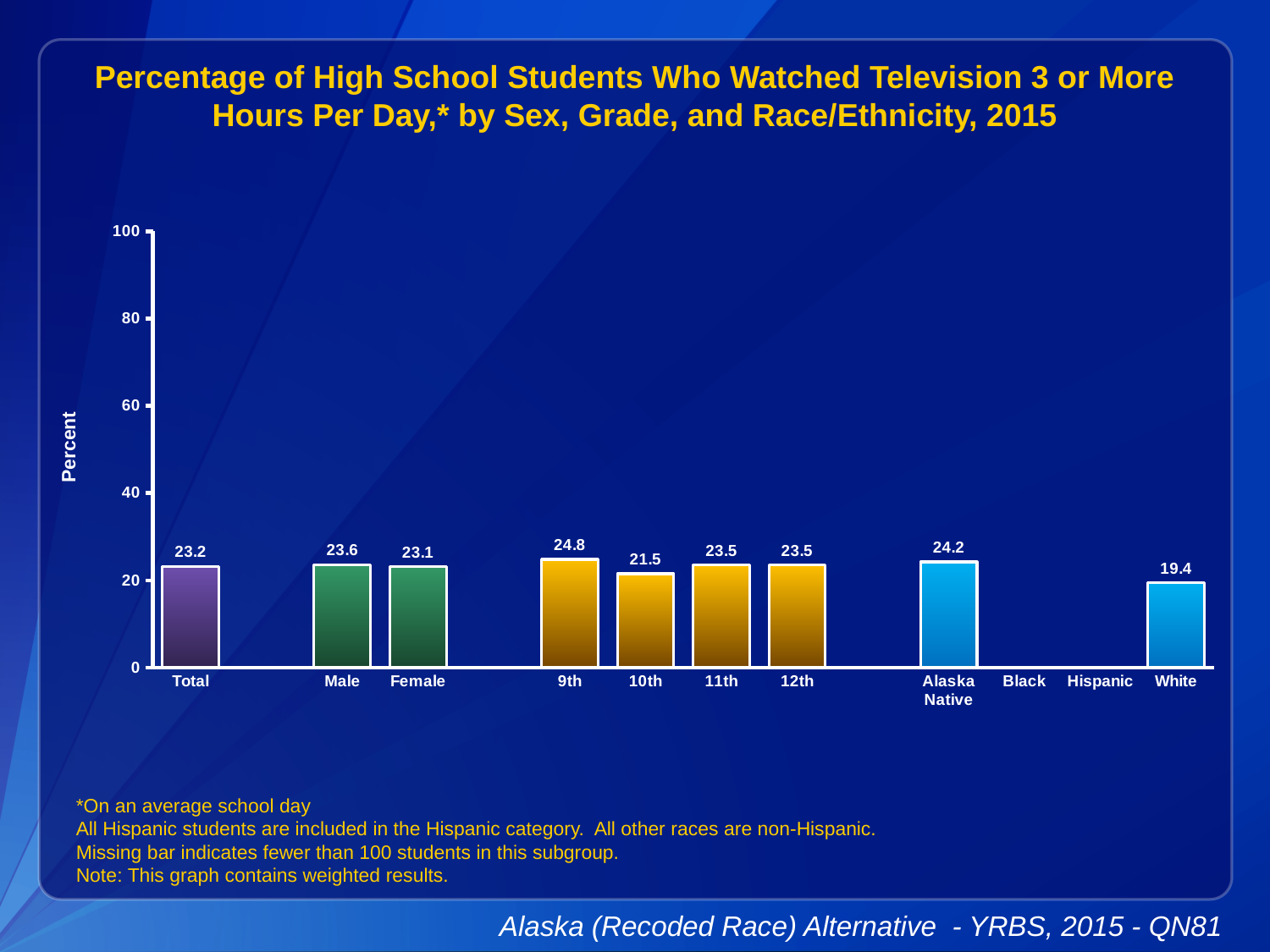
What kind of chart is shown on the slide? bar chart What is the difference between the values for 9th and 10th grade? 3.3 What is the value for 10th grade? 21.5 Which category has the highest value? 9th What is the value for White? 19.4 What is the value for Total? 23.2 How many categories have a plotted bar? 9 What is the value for Male? 23.6 Which is larger, the value for Alaska Native or the value for White? Alaska Native Which category with a plotted bar has the lowest value? White Which categories on the x axis have no bar shown? Black and Hispanic Is the value for 9th grade greater or less than 40? less